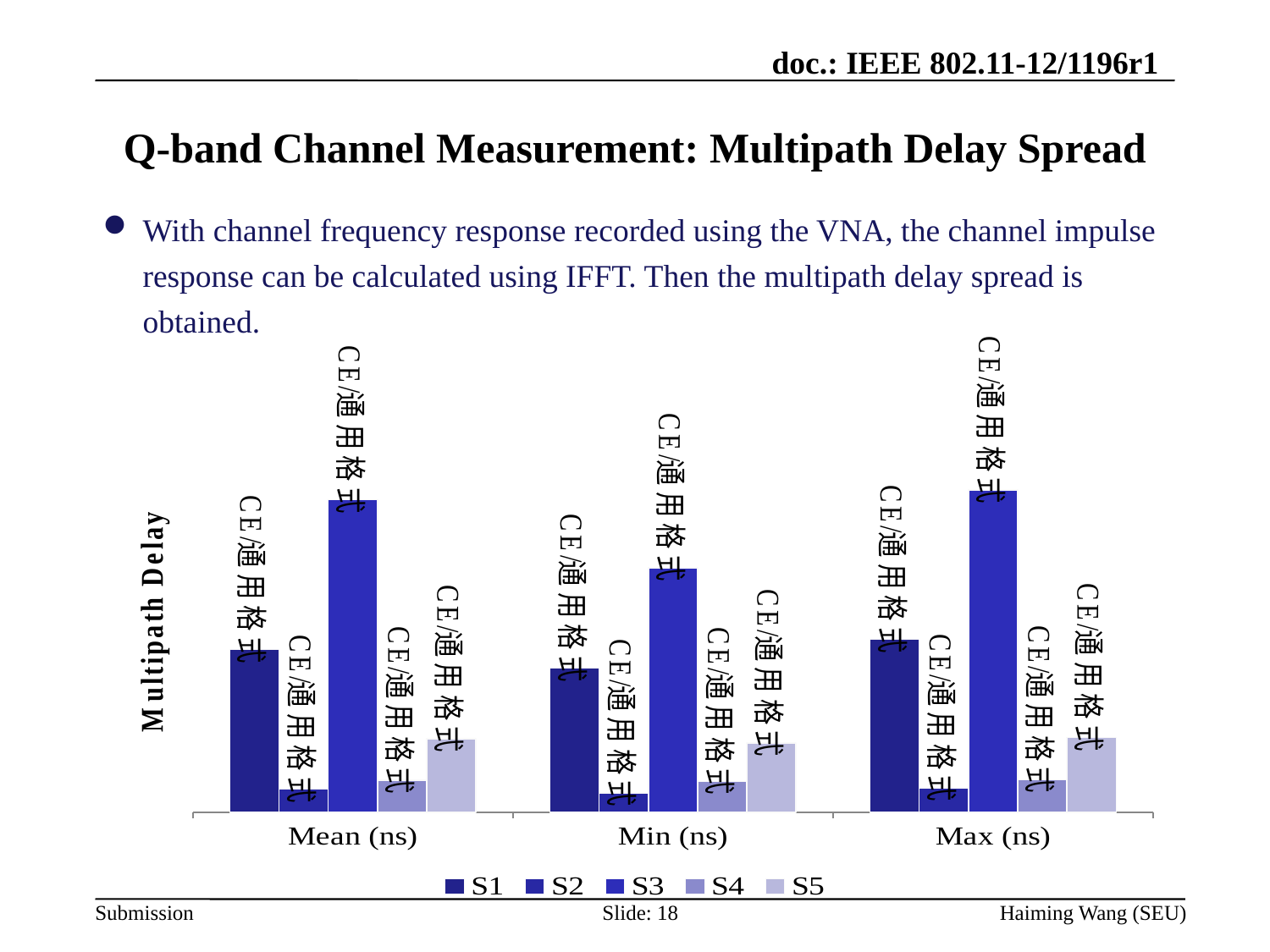
What is the title of the chart's vertical axis? Multipath Delay In the Mean (ns) category, which is larger, S4 or S5? S5 Which series has the highest value in the Min (ns) category? S3 In the Min (ns) category, which is larger, S1 or S5? S1 How many series does the chart's legend list? 5 What are the three category labels on the x axis of the chart? Mean (ns), Min (ns), Max (ns) How many categories are shown on the x axis of the chart? 3 In the Max (ns) category, which is larger, S1 or S3? S3 What kind of chart is shown on the slide? bar chart Which series has the highest value in the Mean (ns) category? S3 Which series has the lowest value in the Mean (ns) category? S2 Which series has the lowest value in the Max (ns) category? S2